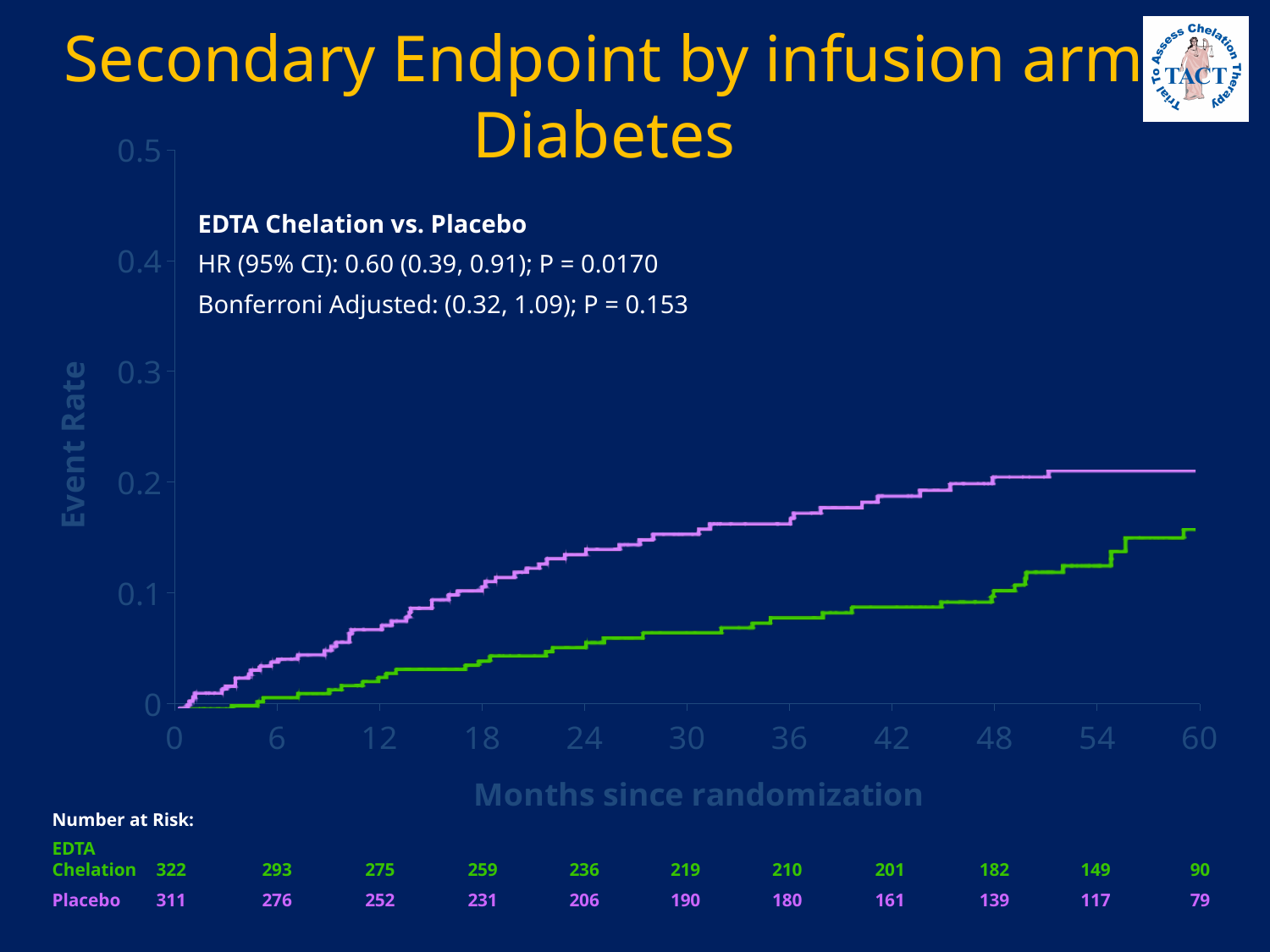
What is the difference between the number at risk for EDTA Chelation and Placebo at month 0? 11 What kind of chart is shown on the slide? line chart Is the event rate for the EDTA Chelation arm at 60 months greater or less than 0.2? less What is the number at risk for the Placebo arm at month 60? 79 What is the label of the x axis? Months since randomization At 36 months, which arm has the higher event rate, EDTA Chelation or Placebo? Placebo How many series (treatment arms) are plotted on the chart? 2 Is the event rate for the Placebo arm at 60 months greater or less than 0.1? greater Do the event rate curves rise or fall as months since randomization increase? rise What is the label of the y axis? Event Rate What is the hazard ratio reported for EDTA Chelation vs. Placebo? 0.60 What is the number at risk for the EDTA Chelation arm at month 0? 322